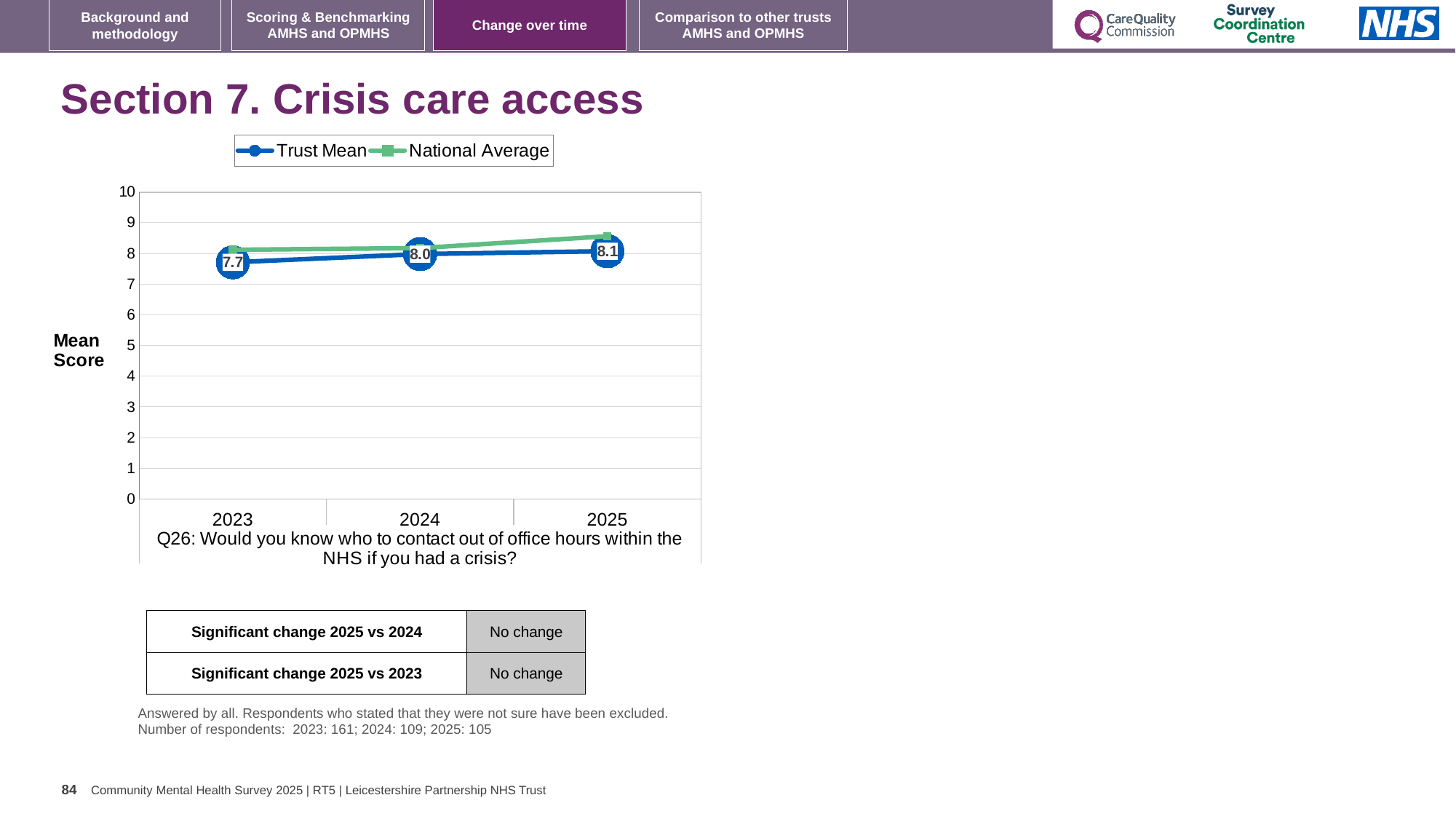
How many years are shown on the x axis? 3 What kind of chart is shown? line chart Does the Trust Mean rise or fall from 2023 to 2025? rise What is the Trust Mean for 2025? 8.1 In which year is the Trust Mean lowest? 2023 Is the Trust Mean for 2023 greater or less than 7? greater What is the difference between the Trust Mean in 2025 and in 2023? 0.4 What is the Trust Mean for 2024? 8.0 What is the Trust Mean for 2023? 7.7 How many series does the legend list? 2 Is the National Average for 2025 greater or less than 9? less In which year is the Trust Mean highest? 2025